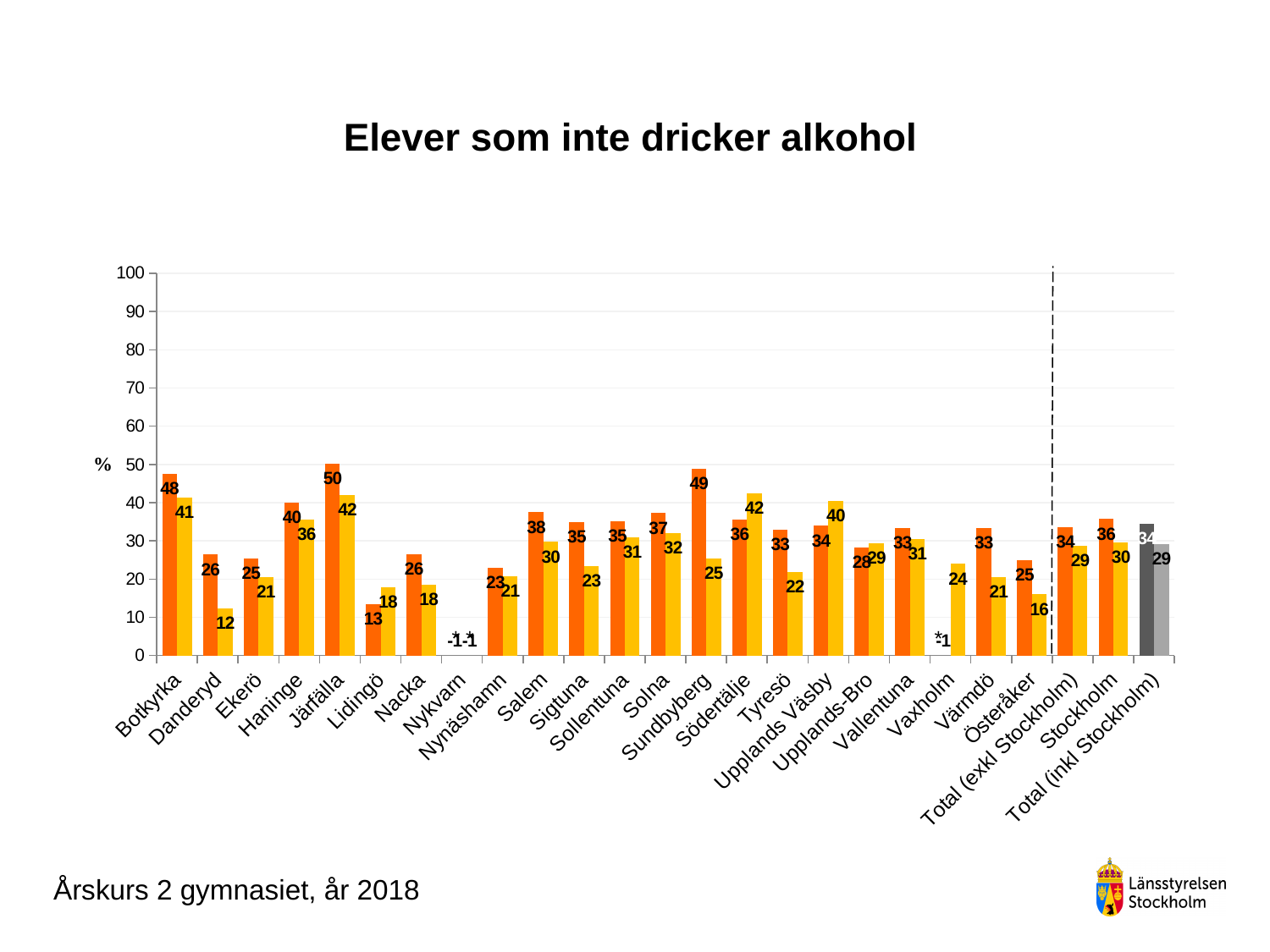
What is the difference between the orange and yellow bars for Sundbyberg? 24 What is the title of the chart? Elever som inte dricker alkohol What unit is shown on the y axis? % Which municipality has the lowest yellow bar among those with a plotted value? Danderyd Is the orange bar for Sundbyberg greater or less than 40? greater What kind of chart is shown on the slide? bar chart Which municipality has the highest orange bar? Järfälla What is the value of the orange bar for Stockholm? 36 What is the difference between the orange and yellow bars for Botkyrka? 7 For Södertälje, which is larger, the orange bar or the yellow bar? the yellow bar What is the value of the orange bar for Järfälla? 50 What is the value of the yellow bar for Danderyd? 12